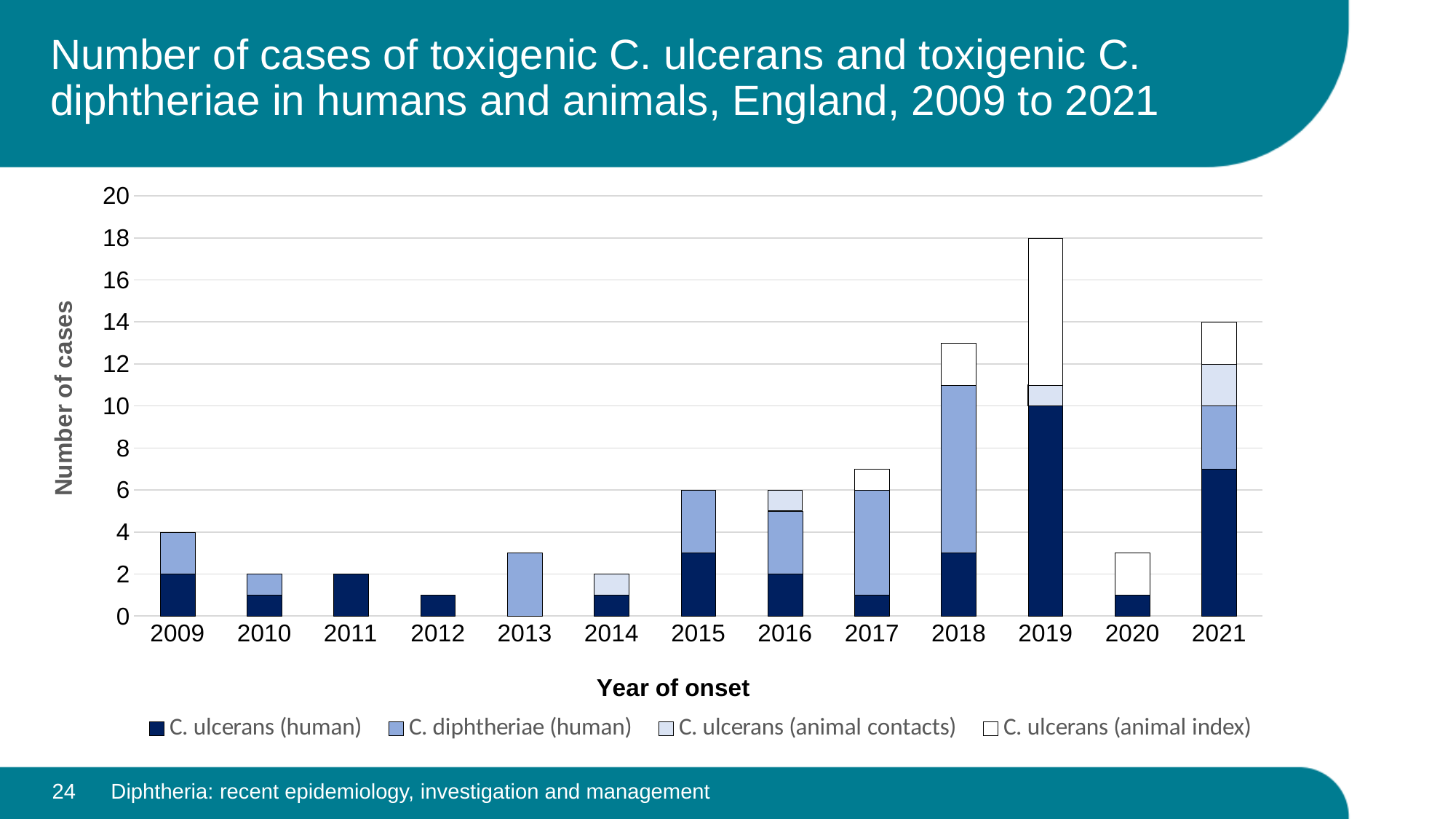
Is the total number of cases in 2018 greater or less than 12? greater Which year has the highest total number of cases? 2019 How many years are shown on the x axis? 13 What is the total number of cases in 2015? 6 How many C. ulcerans (human) cases were there in 2011? 2 What kind of chart is shown on the slide? Stacked bar chart How many C. ulcerans (human) cases were there in 2019? 10 What is the total number of cases in 2019? 18 Which year has the lowest total number of cases? 2012 What is the total number of cases in 2021? 14 How many series does the legend list? 4 Which year has a higher total number of cases, 2019 or 2021? 2019